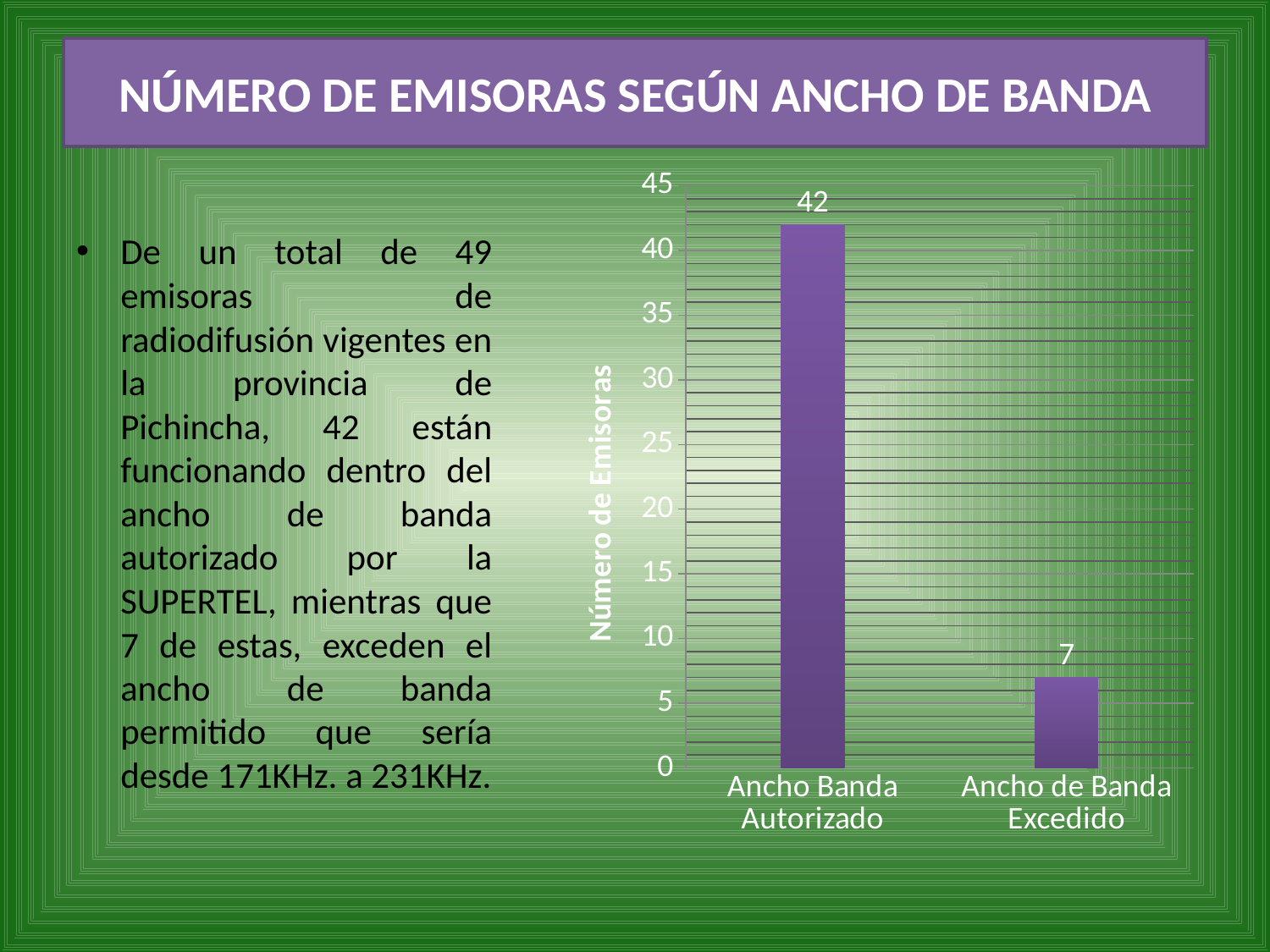
How many categories are shown on the x axis? 2 Is the value for Ancho de Banda Excedido greater or less than 10? less What kind of chart is shown on the slide? bar chart What is the difference between the values for Ancho Banda Autorizado and Ancho de Banda Excedido? 35 What is the highest tick value shown on the vertical axis? 45 What is the label of the vertical axis? Número de Emisoras What is the value for Ancho de Banda Excedido? 7 Which is larger, the value for Ancho Banda Autorizado or the value for Ancho de Banda Excedido? Ancho Banda Autorizado Which category has the highest value? Ancho Banda Autorizado Is the value for Ancho Banda Autorizado greater or less than 40? greater What is the value for Ancho Banda Autorizado? 42 Which category has the lowest value? Ancho de Banda Excedido